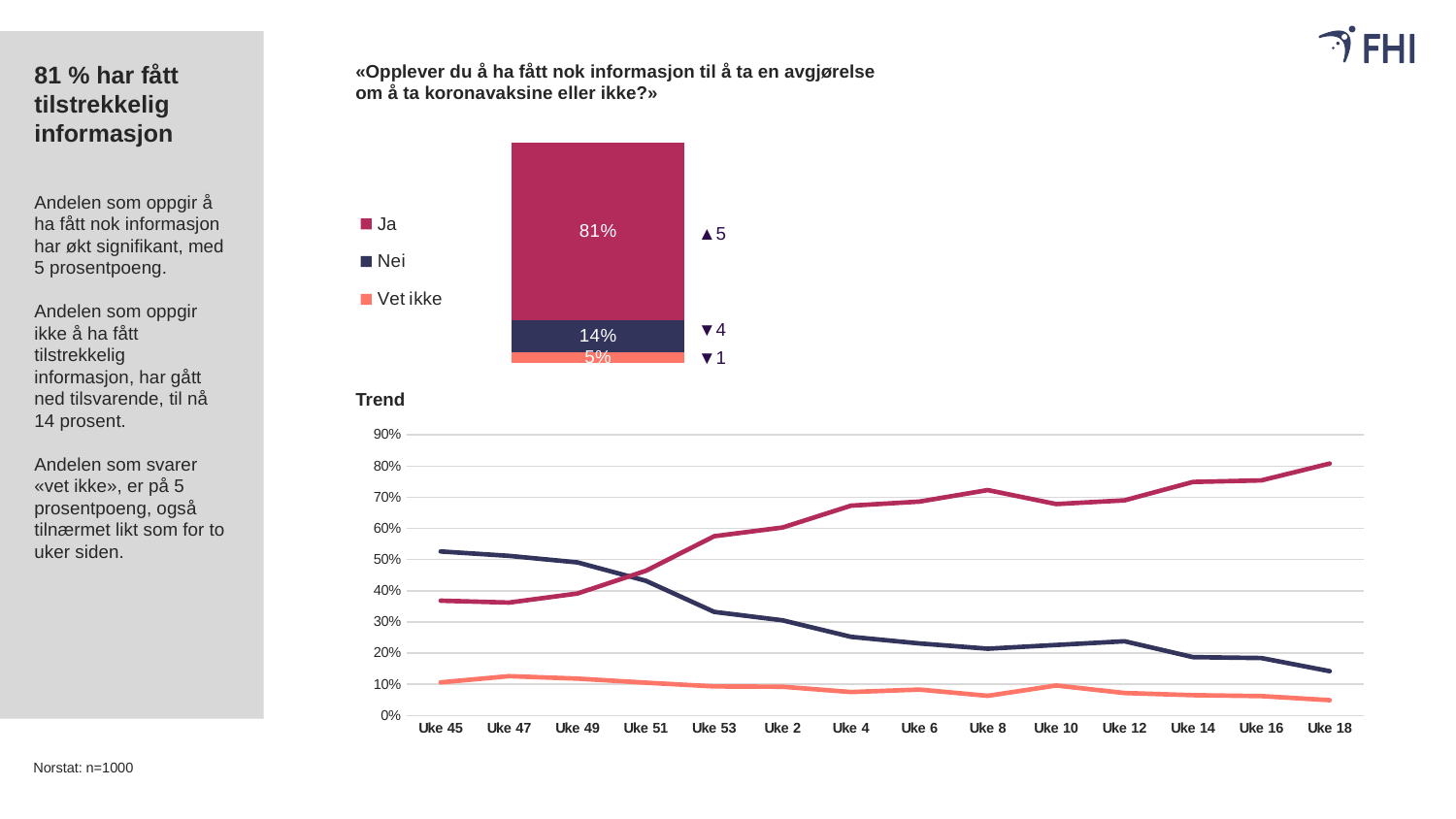
What kind of chart is the "Trend" chart at the bottom? Line chart In the stacked bar chart at the top, what percentage answered "Ja"? 81% In the "Trend" chart, at Uke 45, which is larger: the "Ja" line or the "Nei" line? Nei In the "Trend" chart, is the value for "Nei" at Uke 45 greater or less than 50%? greater In the stacked bar chart at the top, what percentage answered "Nei"? 14% In the stacked bar chart at the top, how many categories does the legend list? 3 In the "Trend" chart, does the "Ja" line rise or fall from Uke 45 to Uke 18? Rises In the stacked bar chart at the top, what percentage answered "Vet ikke"? 5% In the "Trend" chart, how many weeks are shown on the x axis? 14 In the stacked bar chart at the top, what is the difference in percentage points between "Ja" and "Nei"? 67 percentage points In the "Trend" chart, does the "Nei" line rise or fall from Uke 45 to Uke 18? Falls In the stacked bar chart at the top, which response category has the largest share? Ja